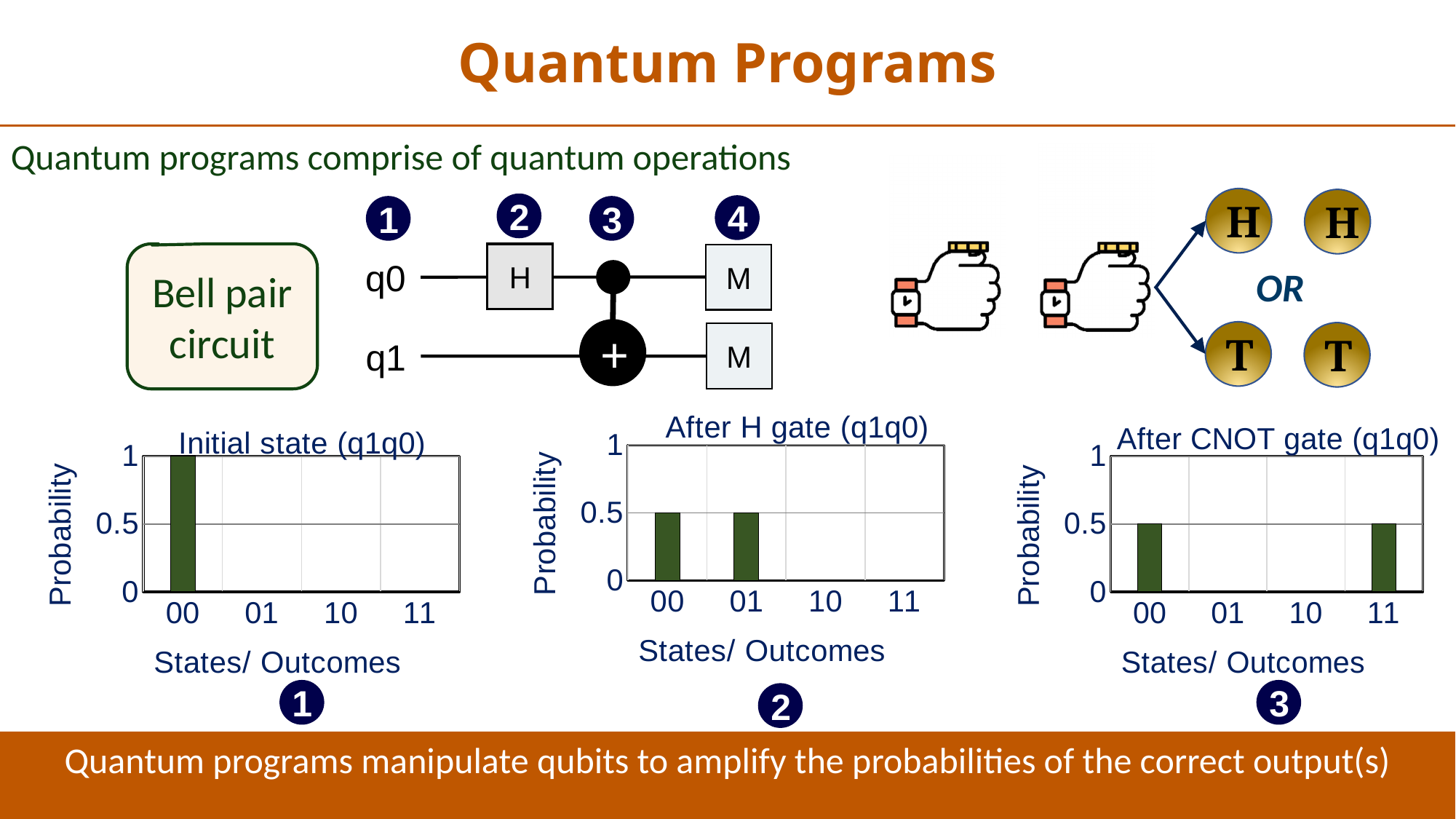
In the 'Initial state (q1q0)' chart, which state has the highest probability? 00 In the 'After H gate (q1q0)' chart, what is the probability for state 10? 0 In the 'Initial state (q1q0)' chart, is the probability for state 00 greater or less than 0.5? greater What kind of chart is the 'After CNOT gate (q1q0)' chart? bar chart In the 'After CNOT gate (q1q0)' chart, what is the probability for state 11? 0.5 How many states are shown on the x axis of the 'Initial state (q1q0)' chart? 4 In the 'After H gate (q1q0)' chart, what is the probability for state 01? 0.5 What is the y-axis label of the 'After H gate (q1q0)' chart? Probability In the 'After CNOT gate (q1q0)' chart, which two states have non-zero probability? 00 and 11 In the 'After H gate (q1q0)' chart, what is the difference between the probabilities for states 00 and 11? 0.5 In the 'After CNOT gate (q1q0)' chart, is the probability for state 00 larger than the probability for state 01? Yes In the 'Initial state (q1q0)' chart, what is the probability for state 00? 1